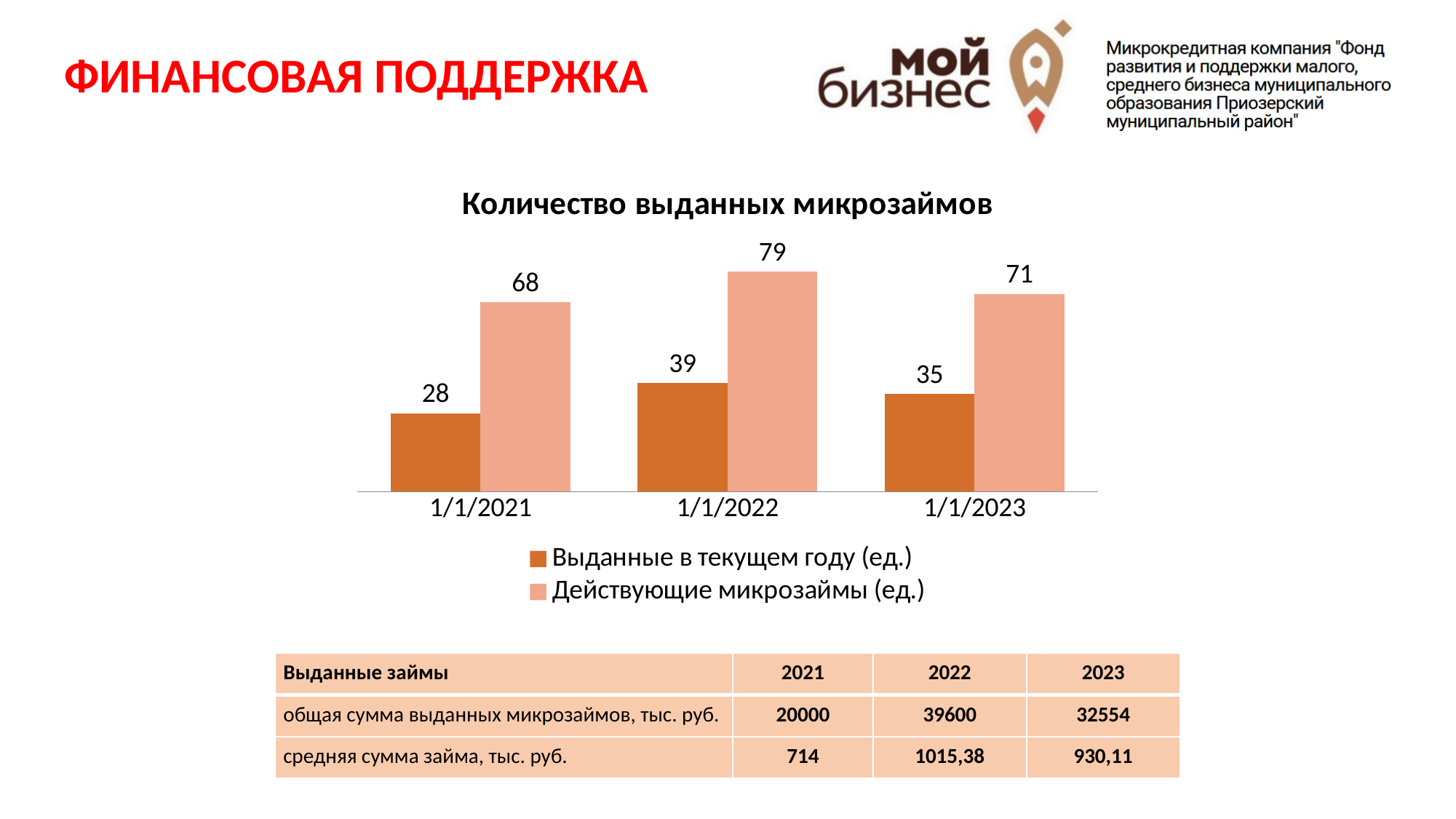
How many series does the chart legend list? 2 What is the value of 'Выданные в текущем году (ед.)' for 1/1/2023? 35 What kind of chart is shown on the slide? bar chart How many dates are shown on the x axis of the chart? 3 What is the value of 'Действующие микрозаймы (ед.)' for 1/1/2022? 79 Which date has the highest value for 'Действующие микрозаймы (ед.)'? 1/1/2022 Which date has the lowest value for 'Выданные в текущем году (ед.)'? 1/1/2021 Does the value of 'Выданные в текущем году (ед.)' rise or fall from 1/1/2021 to 1/1/2022? rise What is the value of 'Выданные в текущем году (ед.)' for 1/1/2021? 28 What is the difference between 'Действующие микрозаймы (ед.)' and 'Выданные в текущем году (ед.)' for 1/1/2023? 36 What is the title of the chart? Количество выданных микрозаймов Which is larger: 'Выданные в текущем году (ед.)' for 1/1/2022 or for 1/1/2023? 1/1/2022